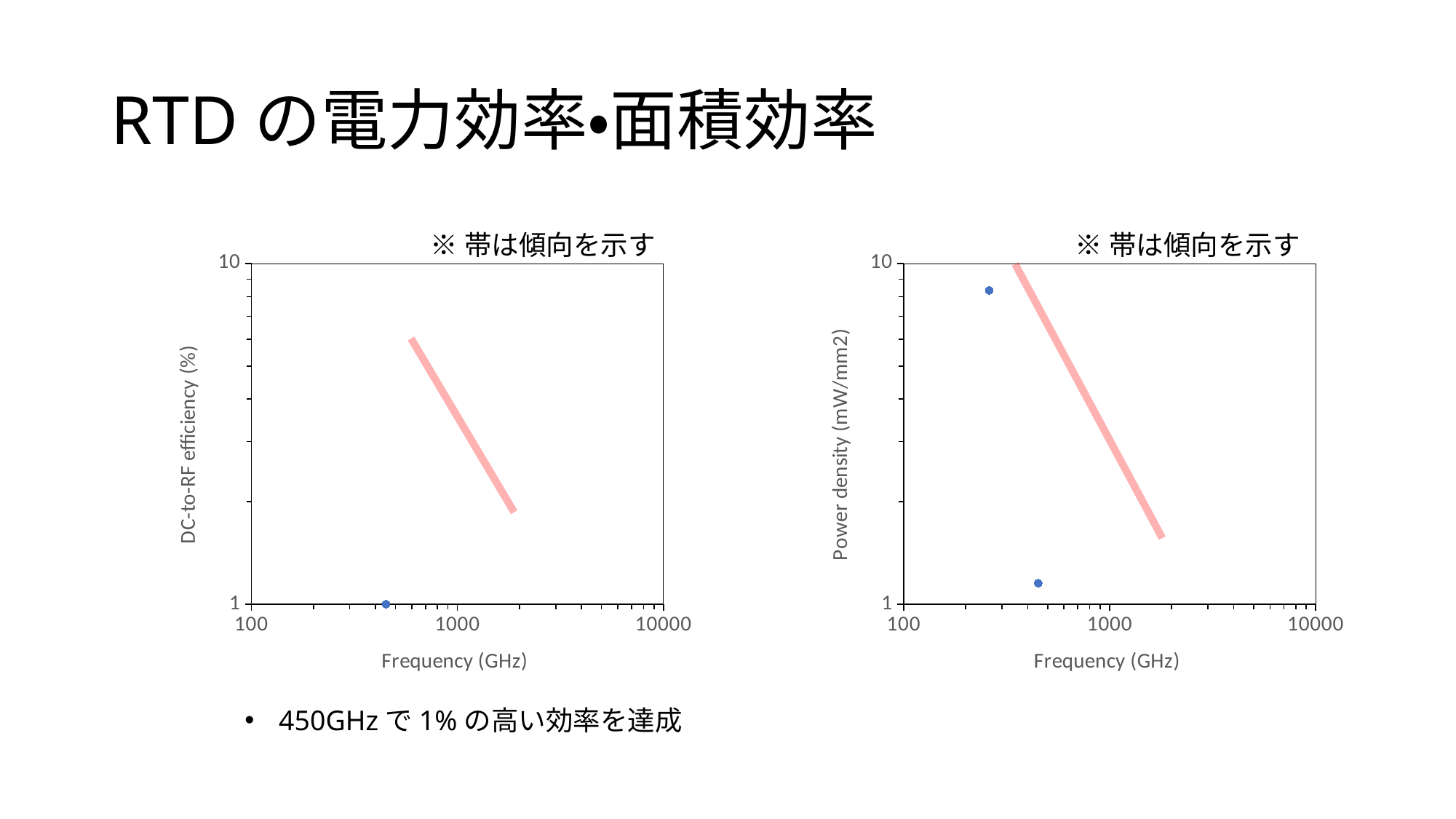
What kind of chart is the left chart (DC-to-RF efficiency vs Frequency)? scatter chart On the right chart, does the red trend band indicate that power density rises or falls as frequency increases? falls How many data points are plotted on the left chart (DC-to-RF efficiency)? 1 On the left chart, does the red trend band indicate that DC-to-RF efficiency rises or falls as frequency increases? falls On the right chart, what is the label of the y axis? Power density (mW/mm2) On the right chart, is the power density of the point at the lower frequency greater or less than 1? greater How many data points are plotted on the right chart (Power density)? 2 On the left chart, what DC-to-RF efficiency value does the plotted point have? 1% On the right chart, which of the two points has the higher power density: the one at the lower frequency or the one at the higher frequency? the one at the lower frequency On the left chart, what is the label of the y axis? DC-to-RF efficiency (%) What kind of chart is the right chart (Power density vs Frequency)? scatter chart On the right chart, is the power density of the point at the lower frequency greater or less than 10? less